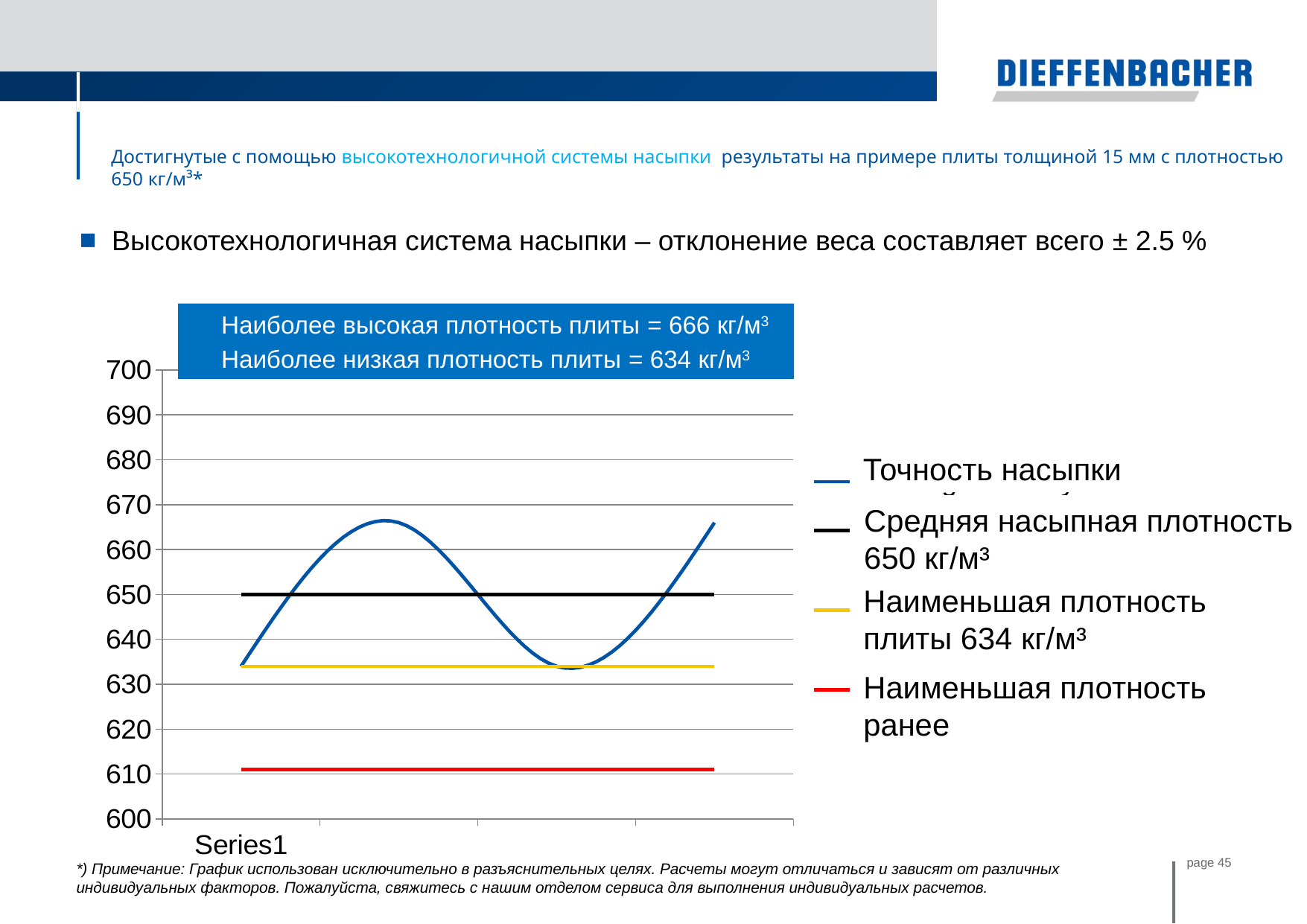
What value does the Средняя насыпная плотность line sit at? 650 кг/м³ What value does the Наименьшая плотность плиты line sit at? 634 кг/м³ How much lower is the Наименьшая плотность плиты line (634 кг/м³) than the Средняя насыпная плотность line (650 кг/м³)? 16 кг/м³ What is the difference between the highest board density (666 кг/м³) and the lowest board density (634 кг/м³) stated on the chart? 32 кг/м³ Which line is higher on the chart: Наименьшая плотность плиты or Наименьшая плотность ранее? Наименьшая плотность плиты What colour is the Точность насыпки line? blue Is the value of the Наименьшая плотность ранее line greater or less than 620? less Which legend series has the lowest value on the chart? Наименьшая плотность ранее According to the text box on the chart, what is the highest board density (Наиболее высокая плотность плиты)? 666 кг/м³ How many series does the chart legend list? 4 What is the highest tick value shown on the vertical axis? 700 What kind of chart is shown on the slide? line chart